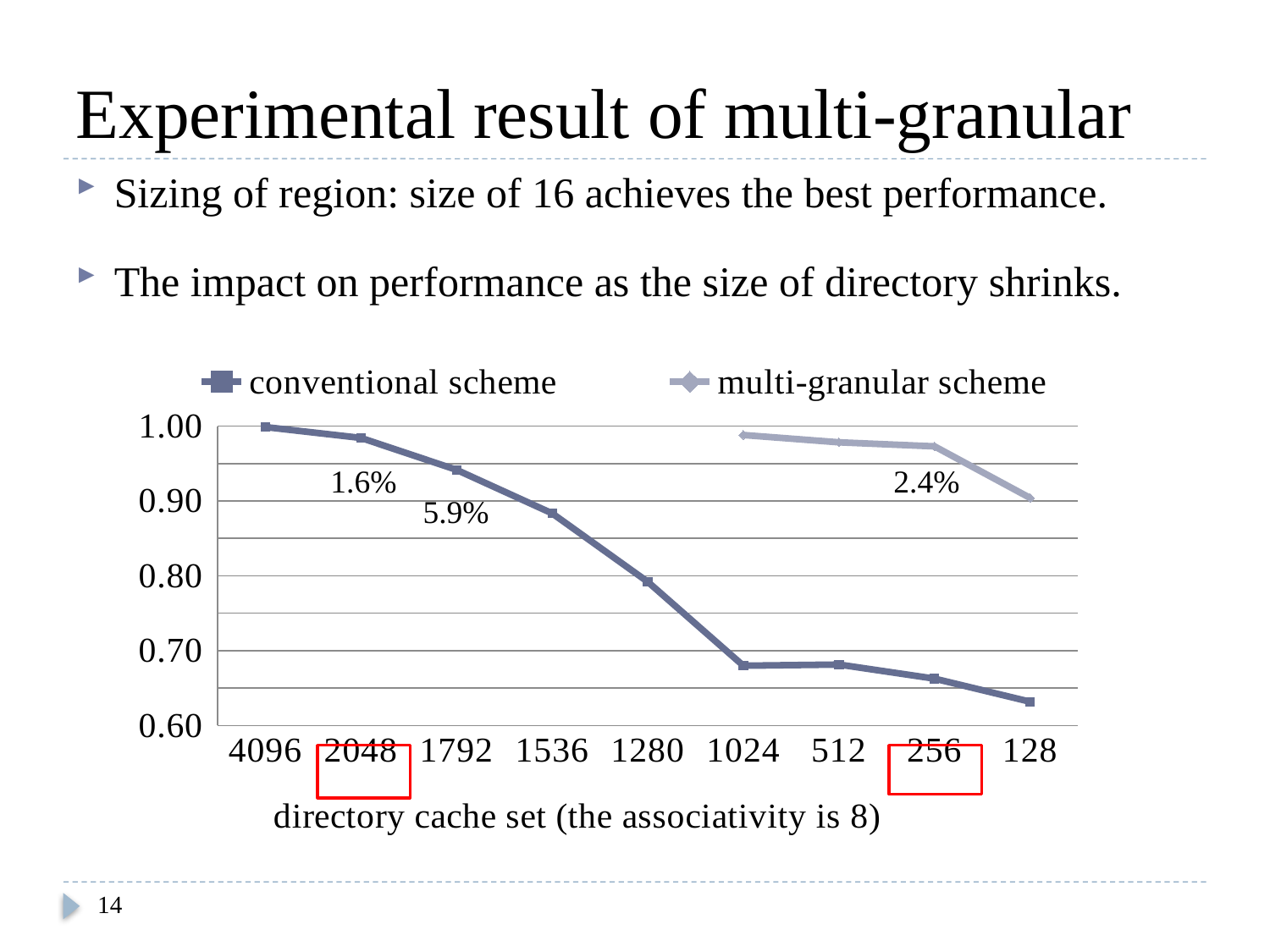
How many directory cache set categories are shown on the x axis? 9 At directory cache set 1024, which series has the larger value, the conventional scheme or the multi-granular scheme? multi-granular scheme Is the value for the conventional scheme at 1792 greater or less than 0.90? greater How many series does the legend list? 2 Is the value for the multi-granular scheme at 1024 greater or less than 0.90? greater Which directory cache set has the lowest value for the conventional scheme? 128 What is the x-axis title of the chart? directory cache set (the associativity is 8) Do the values for the conventional scheme rise or fall as the directory cache set shrinks from 4096 to 128? fall Which directory cache set has the highest value for the conventional scheme? 4096 Is the value for the conventional scheme at 1024 greater or less than 0.70? less What kind of chart is shown on the slide? line chart Which series in the legend is drawn with diamond markers? multi-granular scheme